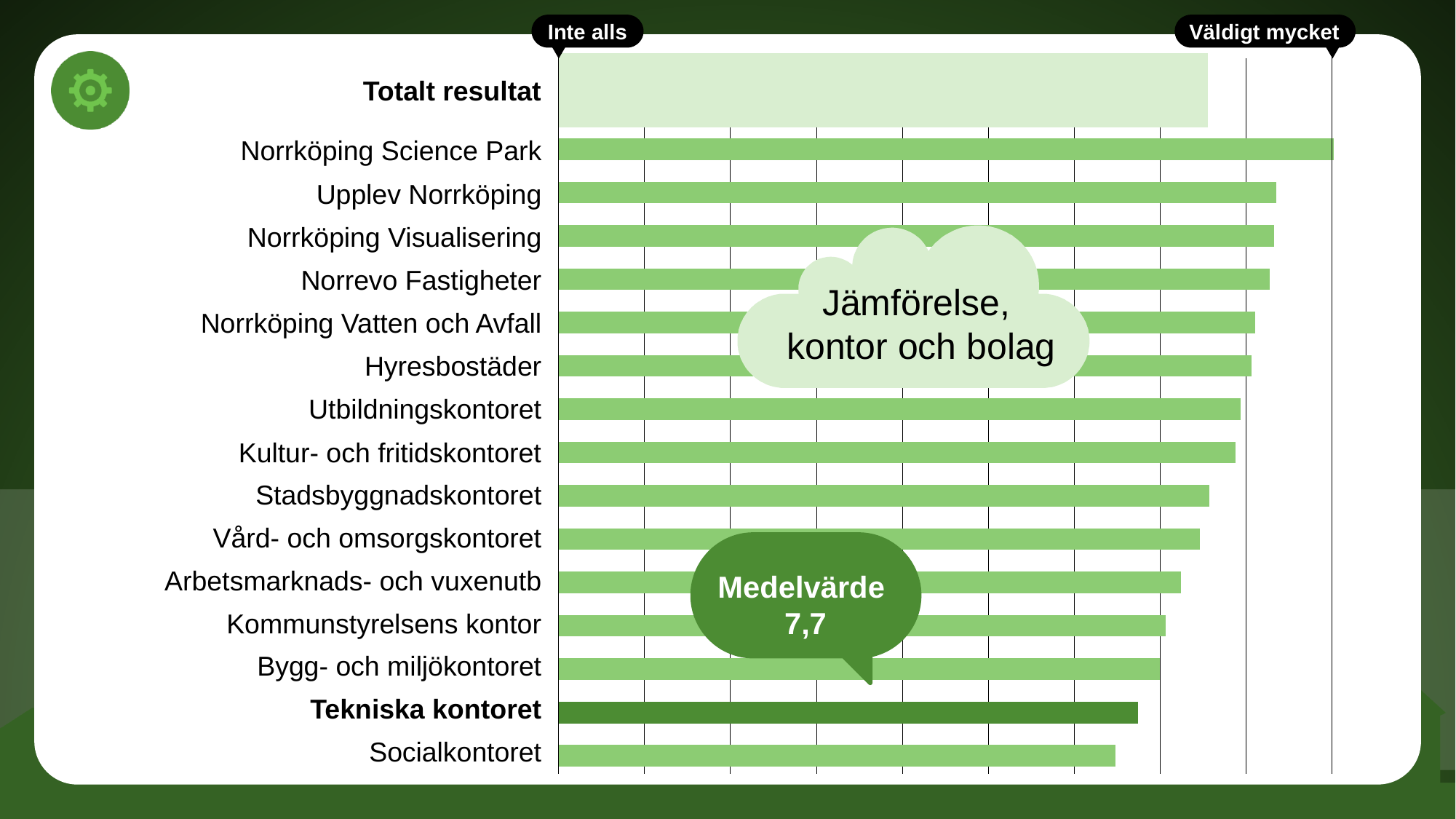
Which office or company has the shortest bar? Socialkontoret Which has the longer bar, Hyresbostäder or Kommunstyrelsens kontor? Hyresbostäder Which has the longer bar, Norrköping Science Park or Socialkontoret? Norrköping Science Park Which has the longer bar, Upplev Norrköping or Stadsbyggnadskontoret? Upplev Norrköping What kind of chart is shown on the slide? bar chart Which office or company has the longest bar? Norrköping Science Park Which category's bar is drawn in a darker green than the others? Tekniska kontoret Going down the list from Norrköping Science Park to Socialkontoret, do the bars get longer or shorter? shorter How many bars are plotted in total, including Totalt resultat? 16 How many offices and companies are listed below Totalt resultat? 15 What mean value (Medelvärde) is shown in the speech bubble? 7,7